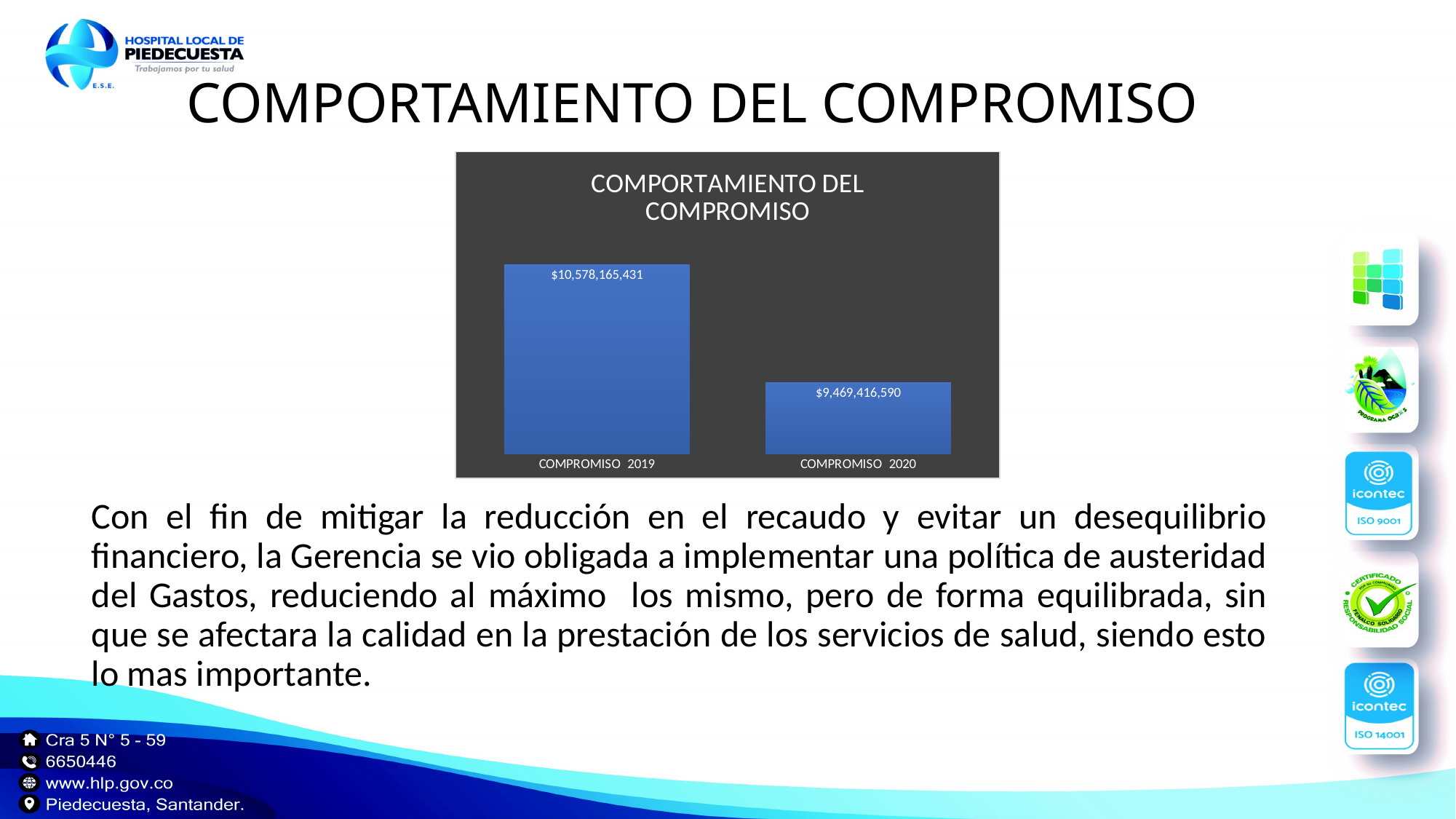
What is the title of the chart? COMPORTAMIENTO DEL COMPROMISO What is the value for COMPROMISO 2019? $10,578,165,431 Which category has the lowest value? COMPROMISO 2020 What colour are the bars in the chart? Blue How many categories are shown in the chart? 2 Which is larger, the value for COMPROMISO 2019 or COMPROMISO 2020? COMPROMISO 2019 What is the value for COMPROMISO 2020? $9,469,416,590 What is the difference between the values for COMPROMISO 2019 and COMPROMISO 2020? $1,108,748,841 What kind of chart is shown on the slide? Bar chart Which category has the highest value? COMPROMISO 2019 Do the values rise or fall from COMPROMISO 2019 to COMPROMISO 2020? Fall